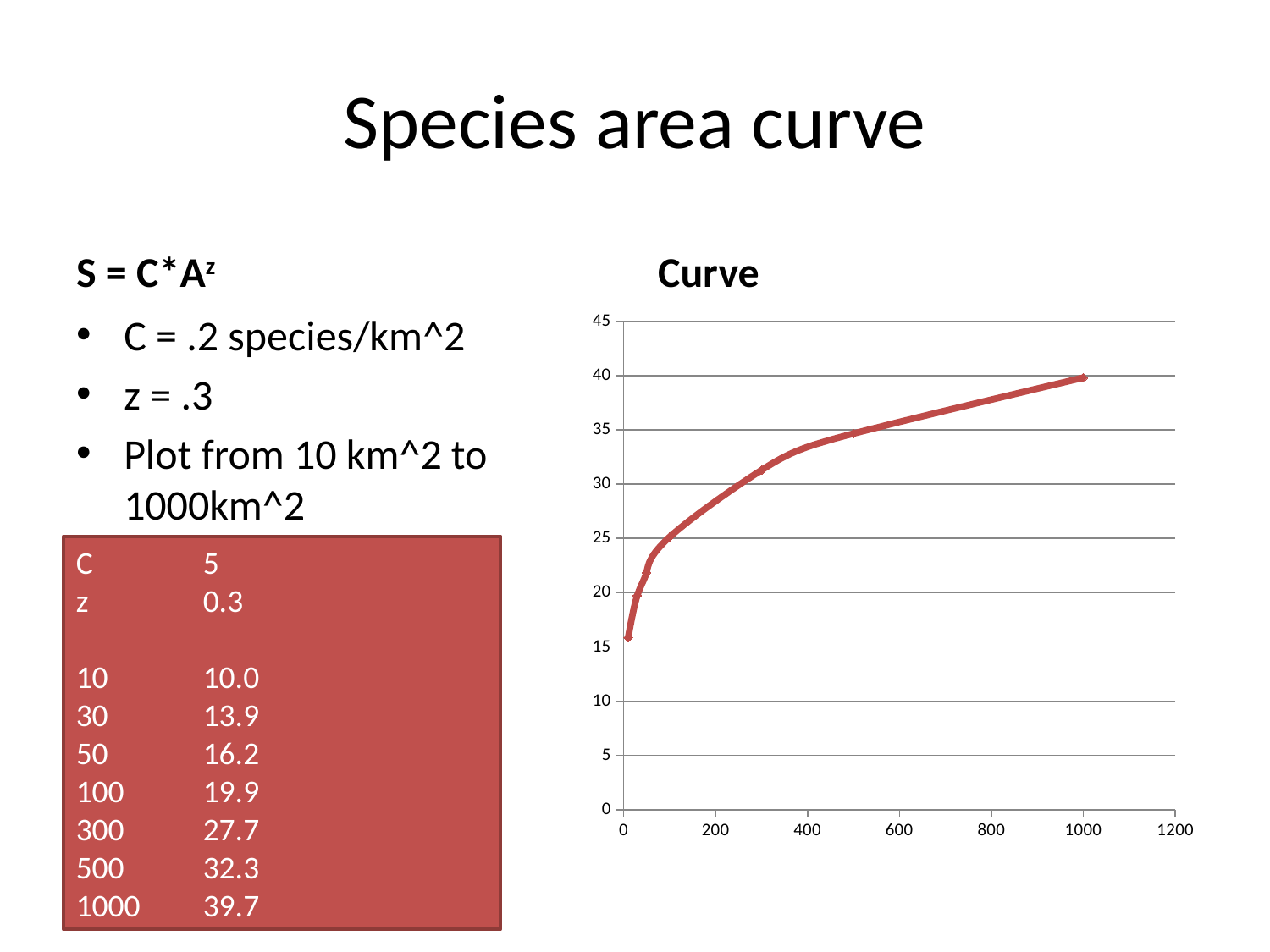
At which x value does the curve reach its highest point? 1000 What is the title of the chart? Curve Is the value of the curve at x = 300 greater or less than 30? greater At which x value is the curve at its lowest point? 10 Is the value of the curve at x = 10 greater or less than 20? less Is the value of the curve at x = 500 greater or less than 30? greater What kind of chart is shown on the slide? line chart Do the plotted values rise or fall as the x axis increases? rise What is the highest value shown on the chart's y axis? 45 Which has the larger value on the curve, x = 500 or x = 300? x = 500 How many data points are plotted on the curve? 7